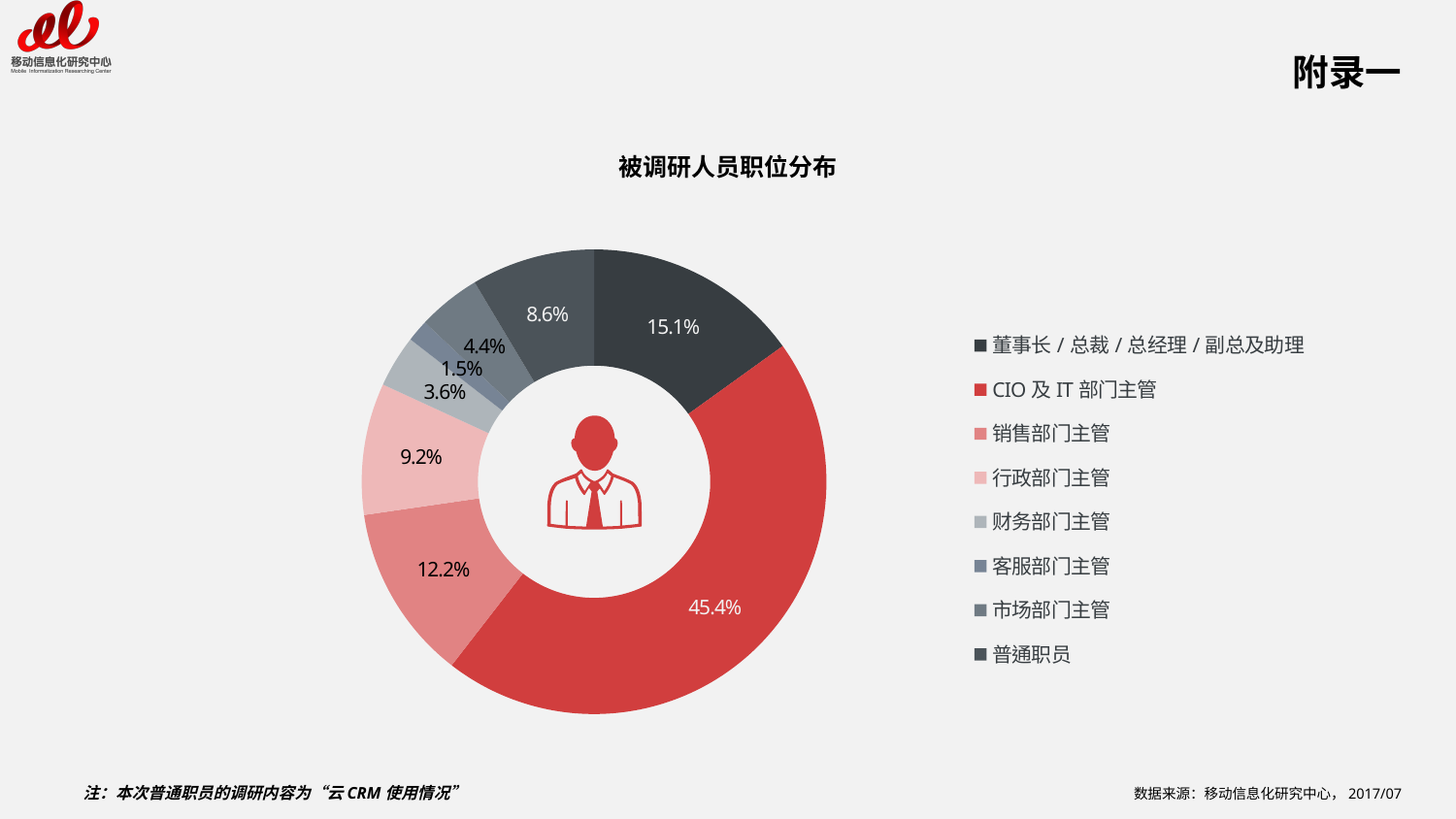
What share of respondents are 董事长 / 总裁 / 总经理 / 副总及助理? 15.1% What kind of chart is shown on the slide? Pie chart (donut) How many job categories does the legend list? 8 What share of respondents are 销售部门主管? 12.2% Which has a larger share, 行政部门主管 or 市场部门主管? 行政部门主管 What share of respondents are CIO 及 IT 部门主管? 45.4% What share of respondents are 普通职员? 8.6% Which job category has the smallest share of respondents? 客服部门主管 What is the title of the chart? 被调研人员职位分布 What is the difference in percentage points between CIO 及 IT 部门主管 and 董事长 / 总裁 / 总经理 / 副总及助理? 30.3 Which job category has the largest share of respondents? CIO 及 IT 部门主管 What share of respondents are 财务部门主管? 3.6%